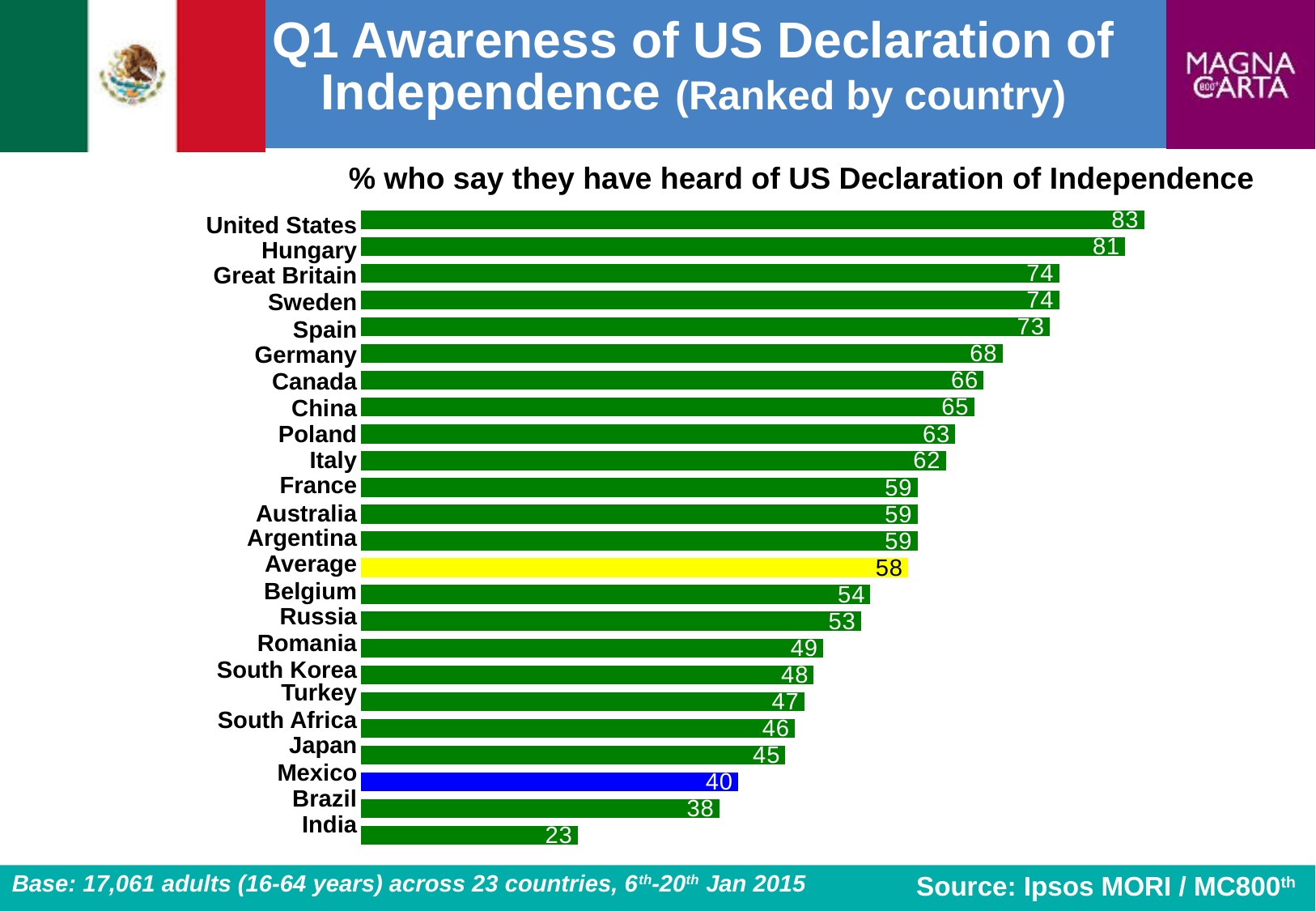
What is the difference between the values for United States and India? 60 Which country has the lowest value? India Which country has the highest value? United States What is the value shown for Average? 58 Which has a larger value, Canada or Belgium? Canada What kind of chart is shown on the slide? Bar chart What is the value for Mexico? 40 What is the value for Germany? 68 What is the difference between the values for Mexico and the Average? 18 Which bar is coloured blue? Mexico Which has a larger value, Brazil or Japan? Japan How many bars are shown in the chart, including the Average? 24